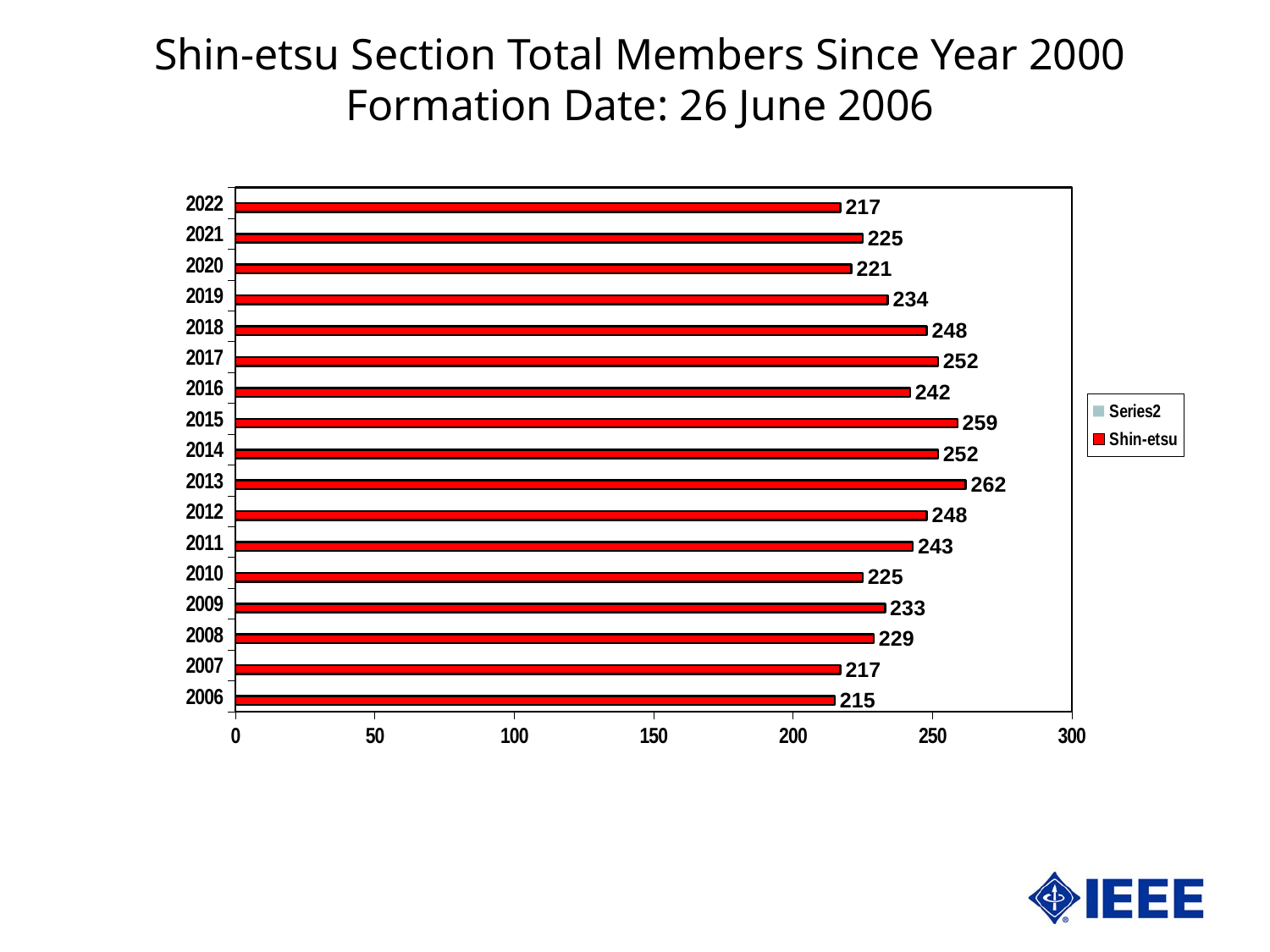
How many series does the legend list? 2 How many years are shown on the chart? 17 Which is larger, the value for 2018 or the value for 2020? 2018 Which year has the highest value? 2013 What is the difference between the values for 2015 and 2022? 42 What colour are the Shin-etsu bars? red What is the difference between the values for 2013 and 2006? 47 What is the value for 2019? 234 What is the value for 2013? 262 What is the value for 2006? 215 What kind of chart is shown? bar chart Which year has the lowest value? 2006